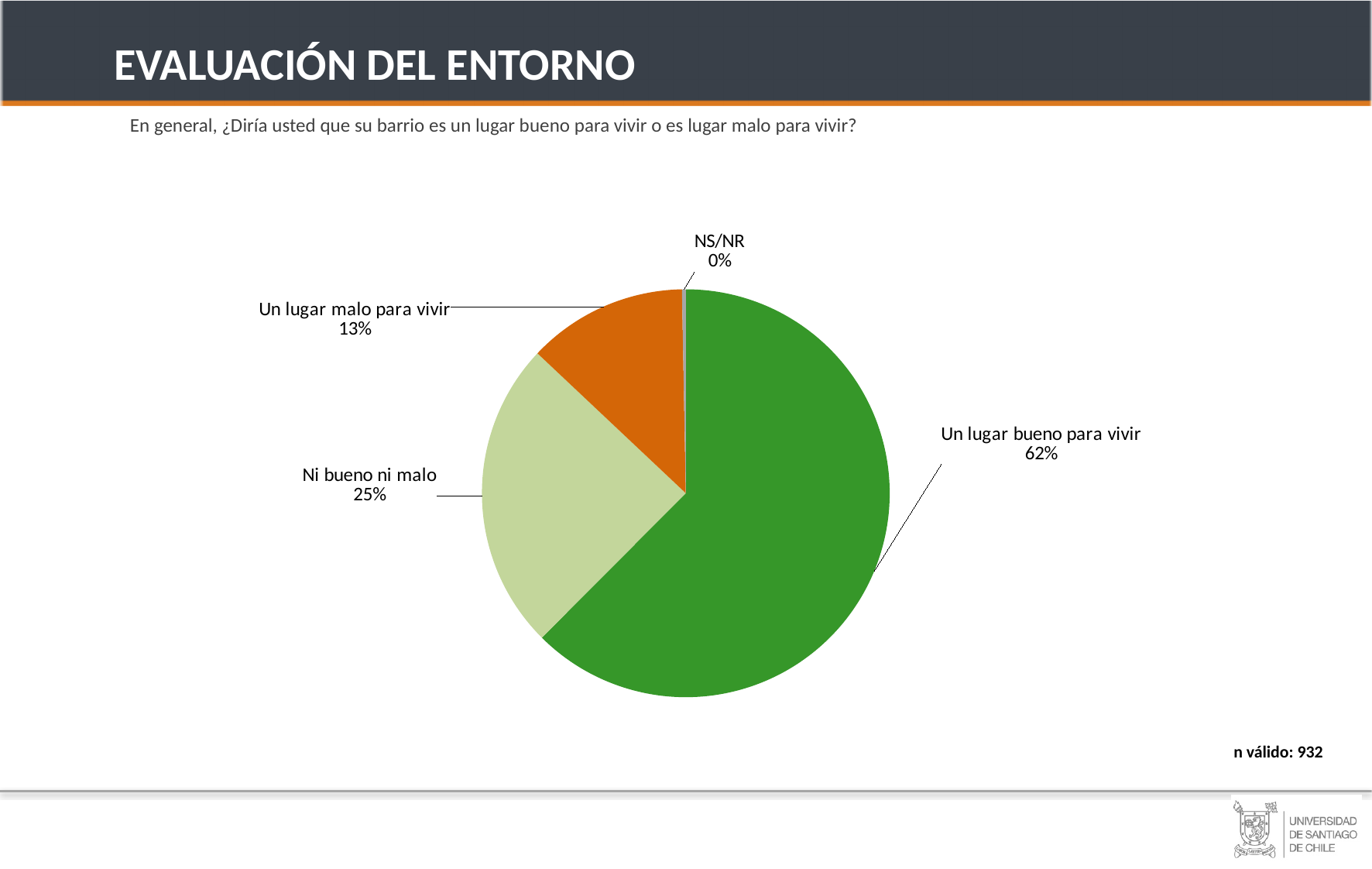
How many categories are shown in the pie chart? 4 What share of the pie is 'Ni bueno ni malo'? 25% What kind of chart is shown on the slide? pie chart What is the difference in percentage points between 'Un lugar bueno para vivir' and 'Ni bueno ni malo'? 37 Which category has the largest slice of the pie? Un lugar bueno para vivir Which is larger, 'Ni bueno ni malo' or 'Un lugar malo para vivir'? Ni bueno ni malo Which category has the smallest slice of the pie? NS/NR What share of the pie is 'Un lugar bueno para vivir'? 62% What is the difference in percentage points between 'Ni bueno ni malo' and 'Un lugar malo para vivir'? 12 What share of the pie is 'NS/NR'? 0% What is the valid n reported on the slide? 932